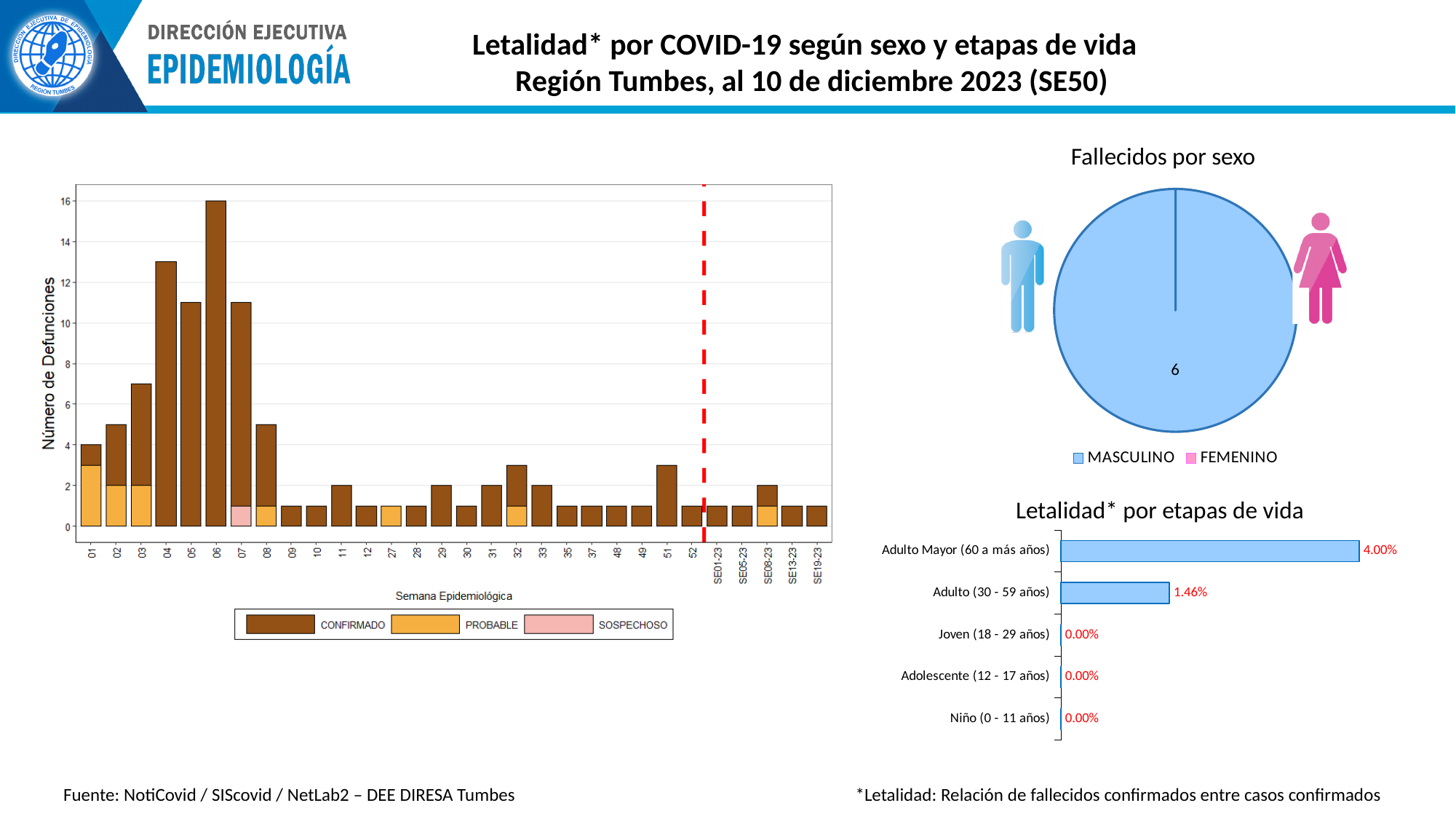
In the 'Letalidad* por etapas de vida' chart, what is the value for Joven (18 - 29 años)? 0.00% In the left chart of 'Número de Defunciones', which epidemiological week has the highest number of deaths? 06 How many categories does the legend of the 'Fallecidos por sexo' pie chart list? 2 In the 'Letalidad* por etapas de vida' chart, what is the value for Adulto Mayor (60 a más años)? 4.00% In the 'Letalidad* por etapas de vida' chart, which age group has the highest value? Adulto Mayor (60 a más años) In the 'Letalidad* por etapas de vida' chart, what is the difference between the values for Adulto Mayor (60 a más años) and Adulto (30 - 59 años)? 2.54% In the left chart of 'Número de Defunciones', what is the number of deaths in week 06? 16 In the 'Letalidad* por etapas de vida' chart, what is the value for Adulto (30 - 59 años)? 1.46% In the 'Letalidad* por etapas de vida' chart, how many age groups are shown? 5 In the 'Fallecidos por sexo' pie chart, what value is shown for MASCULINO? 6 In the left chart of 'Número de Defunciones', is the value for week 04 greater or less than 12? greater What kind of chart is the chart on the left showing 'Número de Defunciones' by 'Semana Epidemiológica'? Stacked bar chart